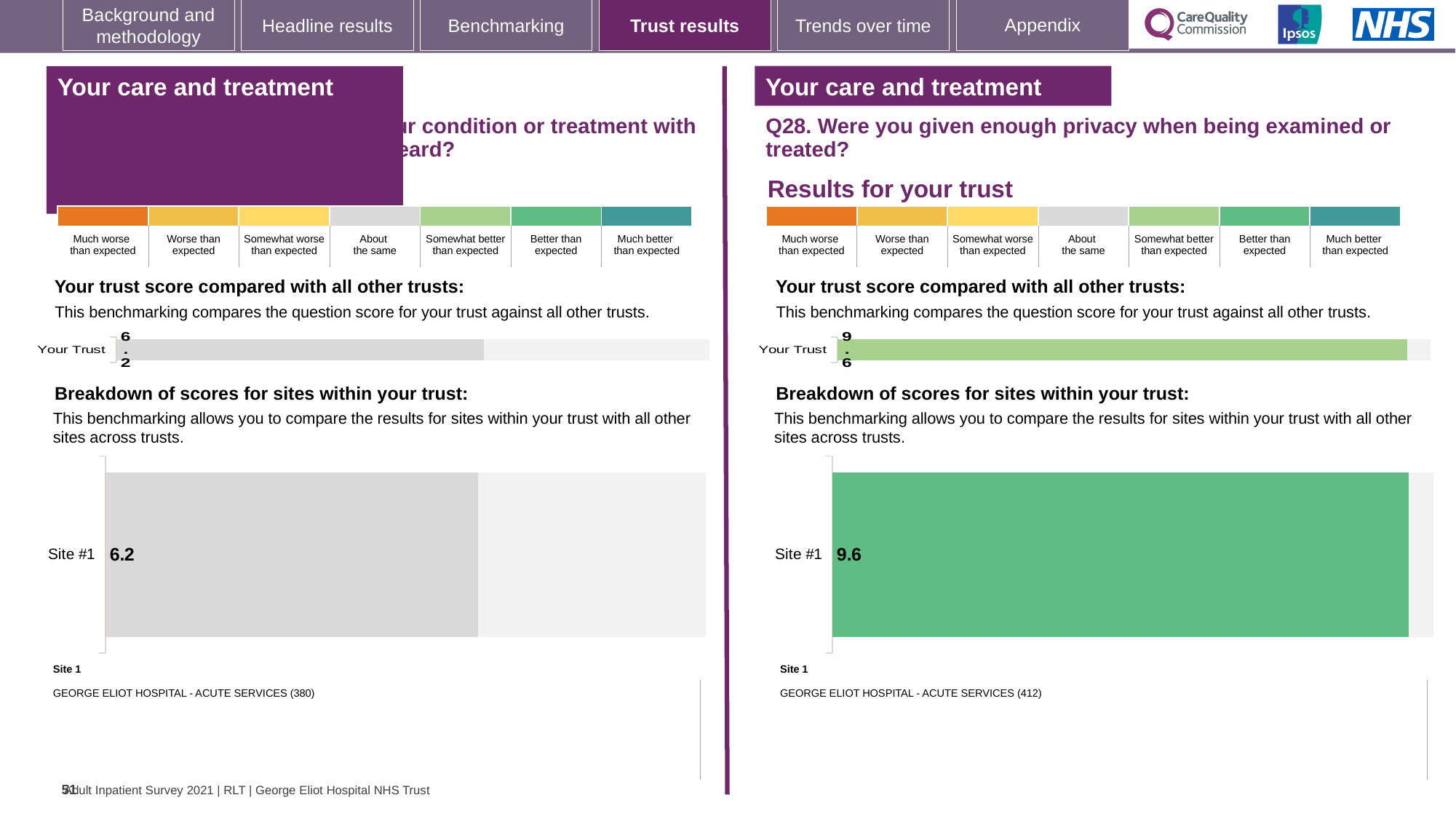
What is the name of Site 1 listed below the breakdown chart on the right-hand panel (Q28)? GEORGE ELIOT HOSPITAL - ACUTE SERVICES (412) On the left-hand panel, what score is shown for Site #1 in the breakdown of sites chart? 6.2 How many sites are shown in the breakdown of sites chart on the right-hand panel (Q28)? 1 What is the name of Site 1 listed below the breakdown chart on the left-hand panel? GEORGE ELIOT HOSPITAL - ACUTE SERVICES (380) What is the difference between the Site #1 score on the right-hand panel (Q28) and the Site #1 score on the left-hand panel? 3.4 How many sites are shown in the breakdown of sites chart on the left-hand panel? 1 What type of chart is used to show the Site #1 score on the right-hand panel (Q28)? Bar chart On the right-hand panel (Q28), what score is shown for Site #1 in the breakdown of sites chart? 9.6 On the left-hand panel, what is the score shown for Your Trust? 6.2 Is the Your Trust score on the right-hand panel (Q28) greater or less than the Your Trust score on the left-hand panel? greater On the right-hand panel (Q28), what is the score shown for Your Trust? 9.6 Which is larger: the Site #1 score on the left-hand panel or the Site #1 score on the right-hand panel (Q28)? Right-hand panel (Q28)